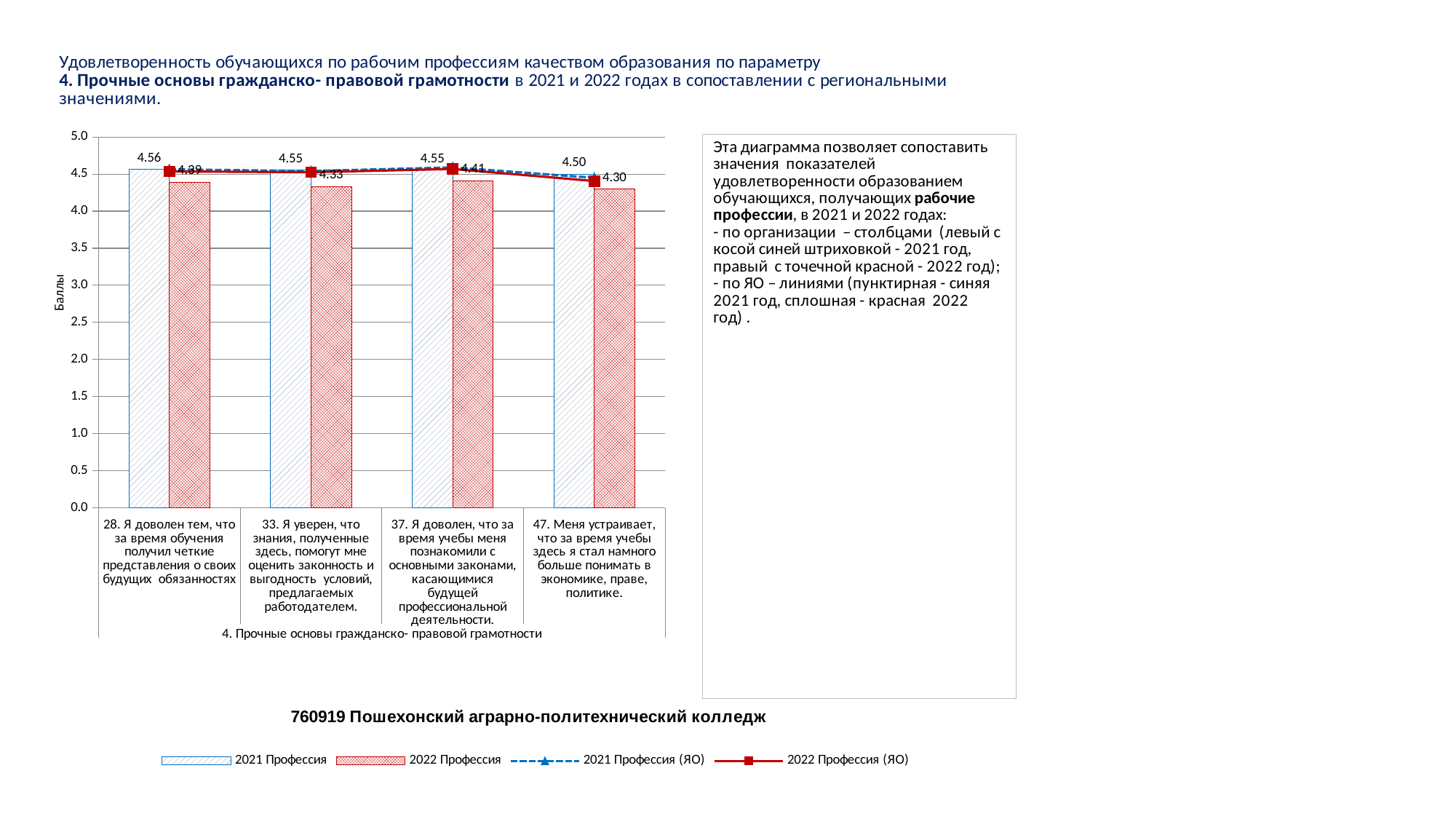
For question 47, which is larger: the 2021 Профессия value or the 2022 Профессия value? 2021 Профессия What is the value of the 2021 Профессия bar for question 37? 4.55 Which question has the highest 2022 Профессия value? 37. Я доволен, что за время учебы меня познакомили с основными законами, касающимися будущей профессиональной деятельности. What is the value of the 2022 Профессия bar for question 47 ("Меня устраивает, что за время учебы здесь я стал намного больше понимать в экономике, праве, политике")? 4.30 How many series does the chart legend list? 4 Which question has the lowest 2021 Профессия value? 47. Меня устраивает, что за время учебы здесь я стал намного больше понимать в экономике, праве, политике. What is the value of the 2021 Профессия bar for question 28 ("Я доволен тем, что за время обучения получил четкие представления о своих будущих обязанностях")? 4.56 How many questions (categories) are shown on the x axis of the chart? 4 What is the value of the 2022 Профессия bar for question 33 ("Я уверен, что знания, полученные здесь, помогут мне оценить законность и выгодность условий, предлагаемых работодателем")? 4.33 Is the 2022 Профессия (ЯО) line value for question 47 greater or less than 4.0? greater What is the difference between the 2021 Профессия and 2022 Профессия values for question 33? 0.22 What is the label of the vertical axis of the chart? Баллы